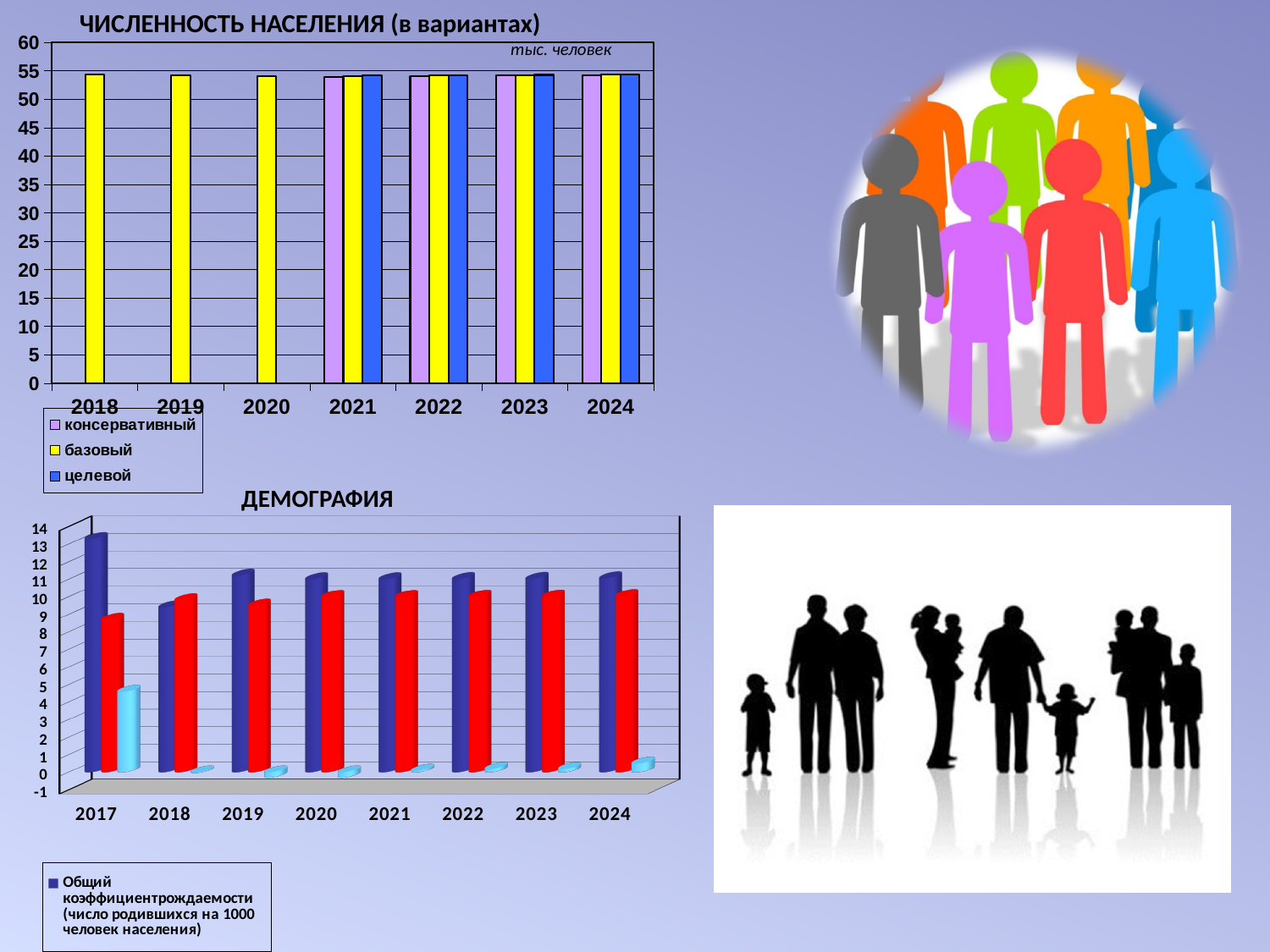
What unit is indicated in the top chart "ЧИСЛЕННОСТЬ НАСЕЛЕНИЯ (в вариантах)"? тыс. человек In the top chart "ЧИСЛЕННОСТЬ НАСЕЛЕНИЯ (в вариантах)", is the value for целевой in 2024 greater or less than 45? greater How many years are shown on the x axis of the bottom chart "ДЕМОГРАФИЯ"? 8 In the bottom chart "ДЕМОГРАФИЯ", is the value of the light blue bar for 2017 greater or less than 3? greater In the top chart "ЧИСЛЕННОСТЬ НАСЕЛЕНИЯ (в вариантах)", is the value for базовый in 2018 greater or less than 50? greater How many years are shown on the x axis of the top chart "ЧИСЛЕННОСТЬ НАСЕЛЕНИЯ (в вариантах)"? 7 In the top chart "ЧИСЛЕННОСТЬ НАСЕЛЕНИЯ (в вариантах)", which series is shown in yellow? базовый How many series does the legend of the top chart "ЧИСЛЕННОСТЬ НАСЕЛЕНИЯ (в вариантах)" list? 3 What kind of chart is the top chart titled "ЧИСЛЕННОСТЬ НАСЕЛЕНИЯ (в вариантах)"? bar chart In the bottom chart "ДЕМОГРАФИЯ", which year has the highest dark blue bar? 2017 What kind of chart is the bottom chart titled "ДЕМОГРАФИЯ"? bar chart